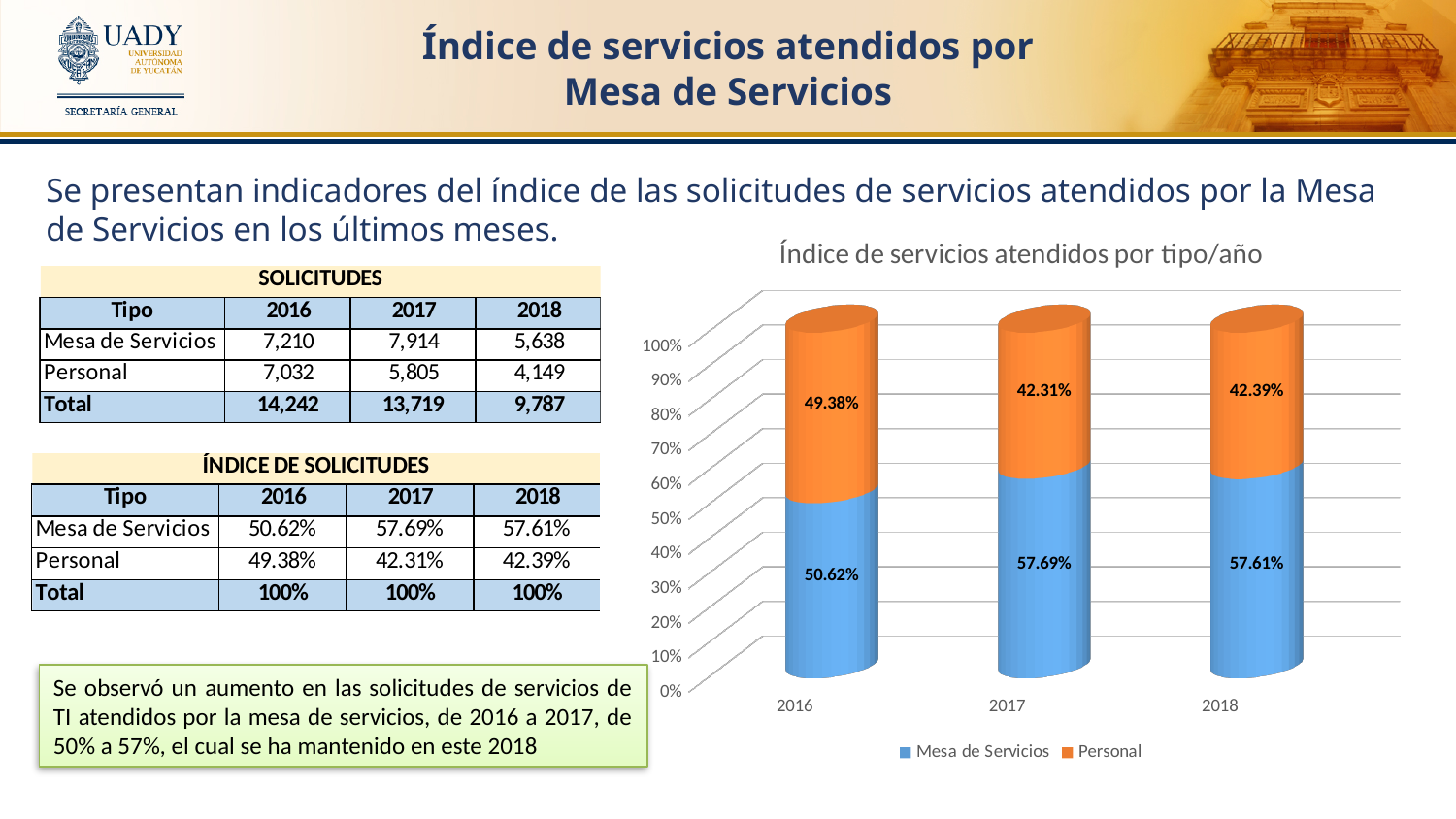
Which is larger in 2017, Mesa de Servicios or Personal? Mesa de Servicios What is the value for Personal in 2017? 42.31% What is the value for Personal in 2018? 42.39% In which year is the Mesa de Servicios share the lowest? 2016 What is the title of the chart? Índice de servicios atendidos por tipo/año How many series does the chart legend list? 2 What type of chart is shown on the slide? stacked bar chart Which colour represents the Personal series in the chart? orange What is the difference between the Mesa de Servicios value in 2017 and in 2016? 7.07% What is the value for Mesa de Servicios in 2016? 50.62% How many years are shown on the x axis of the chart? 3 In which year is the Personal share the highest? 2016